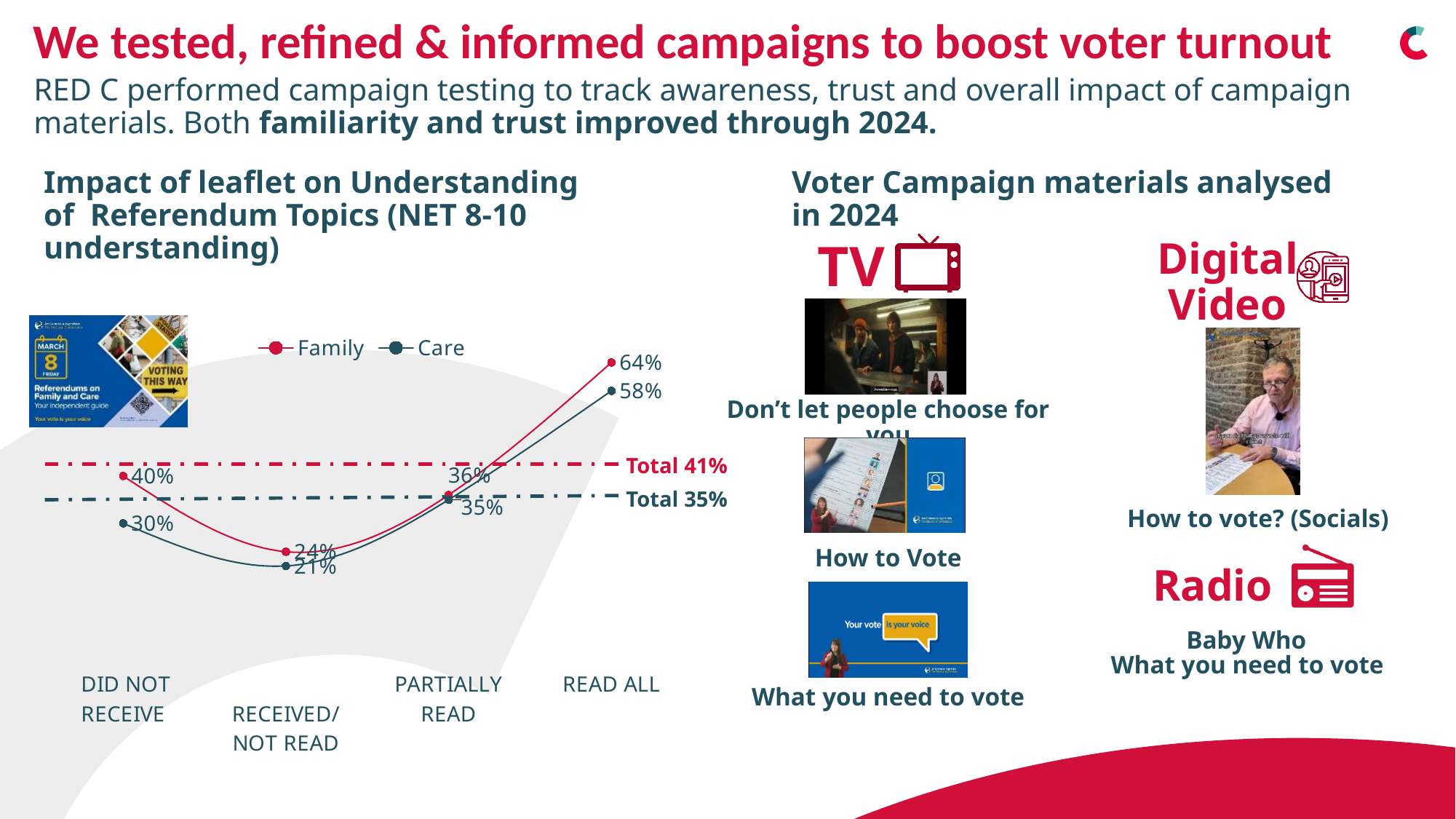
What is the Family value for READ ALL in the leaflet impact chart? 64% What is the Total value shown by the red dashed line in the leaflet impact chart? Total 41% What colour is the Care series line in the leaflet impact chart? dark teal How many categories are shown on the x axis of the leaflet impact chart? 4 Which category has the lowest Care value in the leaflet impact chart? RECEIVED/NOT READ What is the Care value for DID NOT RECEIVE in the leaflet impact chart? 30% What is the difference between the Family and Care values for READ ALL in the leaflet impact chart? 6% Which category has the highest Family value in the leaflet impact chart? READ ALL How many series does the legend of the leaflet impact chart list? 2 What kind of chart is used to show the impact of the leaflet on understanding of referendum topics? line chart What is the Family value for RECEIVED/NOT READ in the leaflet impact chart? 24% Which is larger for DID NOT RECEIVE in the leaflet impact chart, the Family value or the Care value? Family